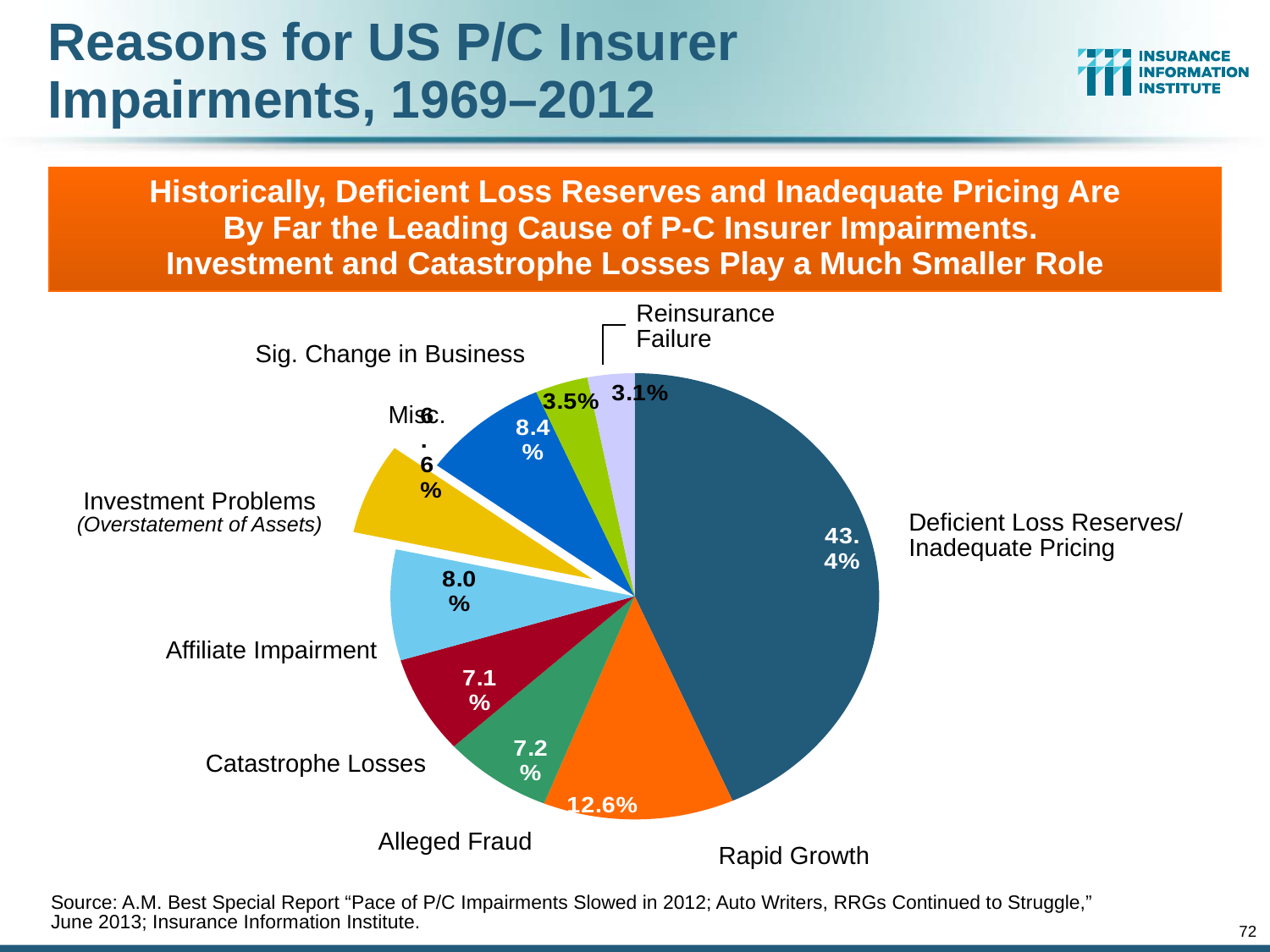
What percentage of impairments is attributed to Reinsurance Failure? 3.1% What percentage of impairments is attributed to Rapid Growth? 12.6% What percentage of impairments is attributed to Alleged Fraud? 7.2% What percentage of impairments is attributed to Catastrophe Losses? 7.1% What type of chart is shown on the slide? Pie chart What percentage of impairments is attributed to Affiliate Impairment? 8.0% Which is larger: the share for Affiliate Impairment or the share for Catastrophe Losses? Affiliate Impairment How many percentage points larger is the Deficient Loss Reserves/Inadequate Pricing share than the Rapid Growth share? 30.8 percentage points What share of US P/C insurer impairments is attributed to Deficient Loss Reserves/Inadequate Pricing? 43.4% Which reason accounts for the largest share of impairments? Deficient Loss Reserves/Inadequate Pricing Which reason accounts for the smallest share of impairments? Reinsurance Failure How many slices does the pie chart have? 9